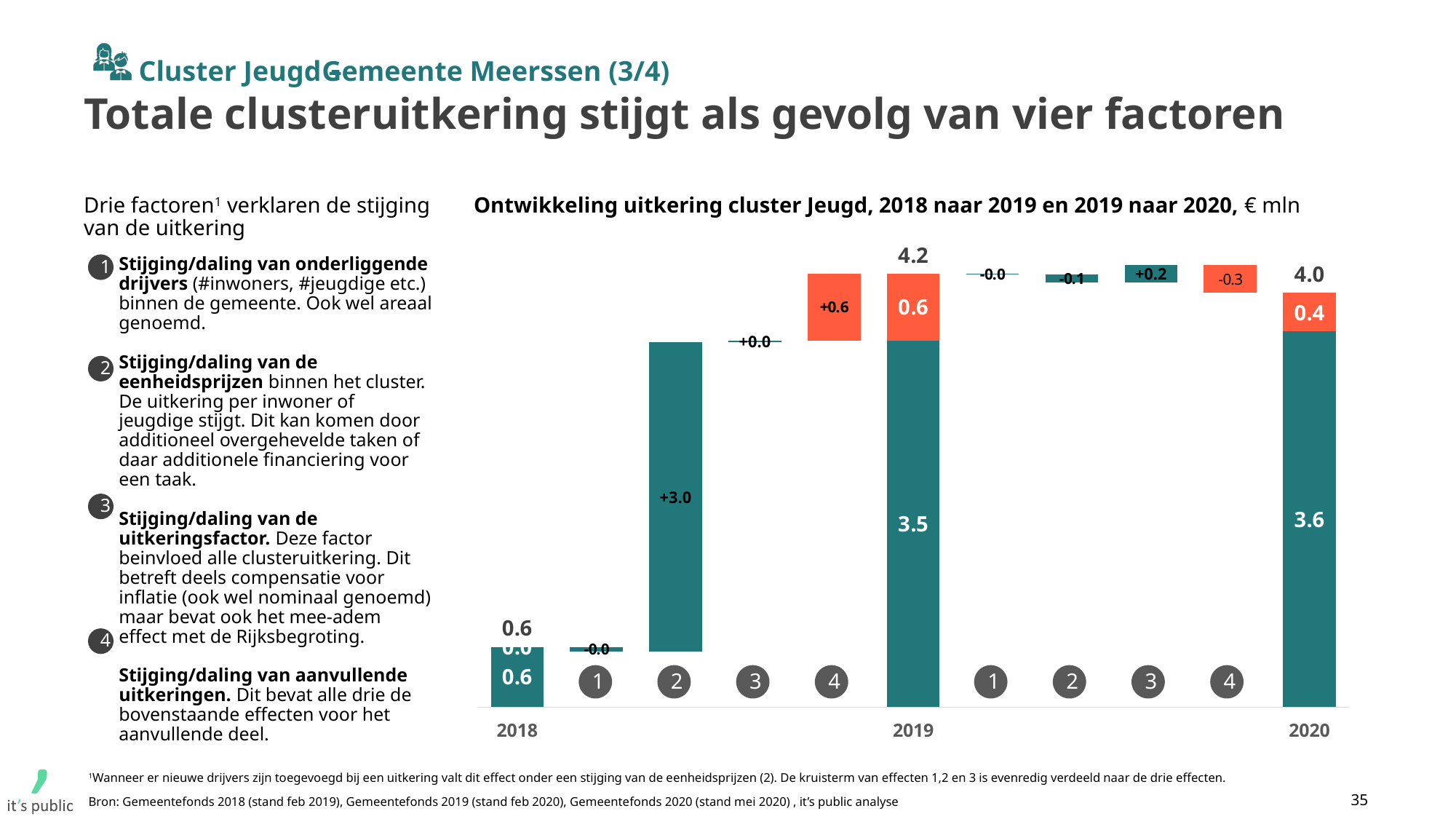
What is the total uitkering for cluster Jeugd in 2018 shown on the chart? 0.6 Which factor contributes the largest change between 2018 and 2019? Factor 2 (+3.0) What is the total uitkering for cluster Jeugd in 2020 shown on the chart? 4.0 What kind of chart is shown on the slide? Waterfall bar chart What is the value of factor 2 (eenheidsprijzen) in the step from 2018 to 2019? +3.0 What is the teal (lower) segment of the 2020 bar? 3.6 What is the value of factor 4 (aanvullende uitkeringen) in the step from 2019 to 2020? -0.3 How many year totals (2018, 2019, 2020) are shown on the chart? 3 What is the unit stated in the chart title? € mln What is the difference between the 2019 total (4.2) and the 2018 total (0.6)? 3.6 Which is larger, the 2019 total or the 2020 total? 2019 total (4.2) What is the total uitkering for cluster Jeugd in 2019 shown on the chart? 4.2